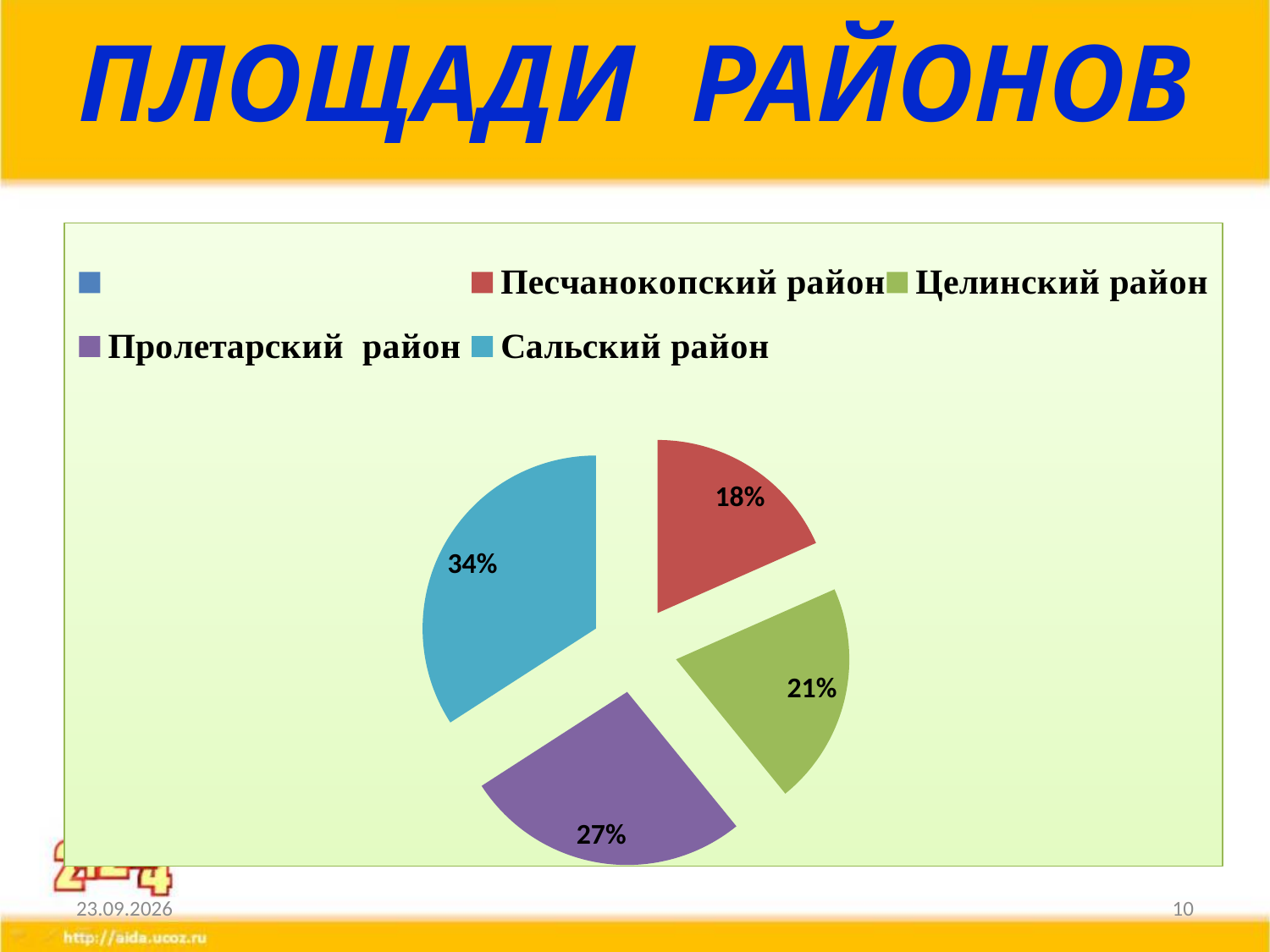
How many slices are shown in the pie chart? 4 What is the difference in percentage points between Сальский район and Песчанокопский район? 16 Which is larger, the slice for Пролетарский район or the slice for Целинский район? Пролетарский район What share of the pie does Целинский район have? 21% What share of the pie does Пролетарский район have? 27% What colour is the slice for Сальский район? blue What is the title of the slide? ПЛОЩАДИ РАЙОНОВ What type of chart is shown on the slide? pie chart Which district has the largest slice of the pie? Сальский район Which district has the smallest slice of the pie? Песчанокопский район What share of the pie does Сальский район have? 34%